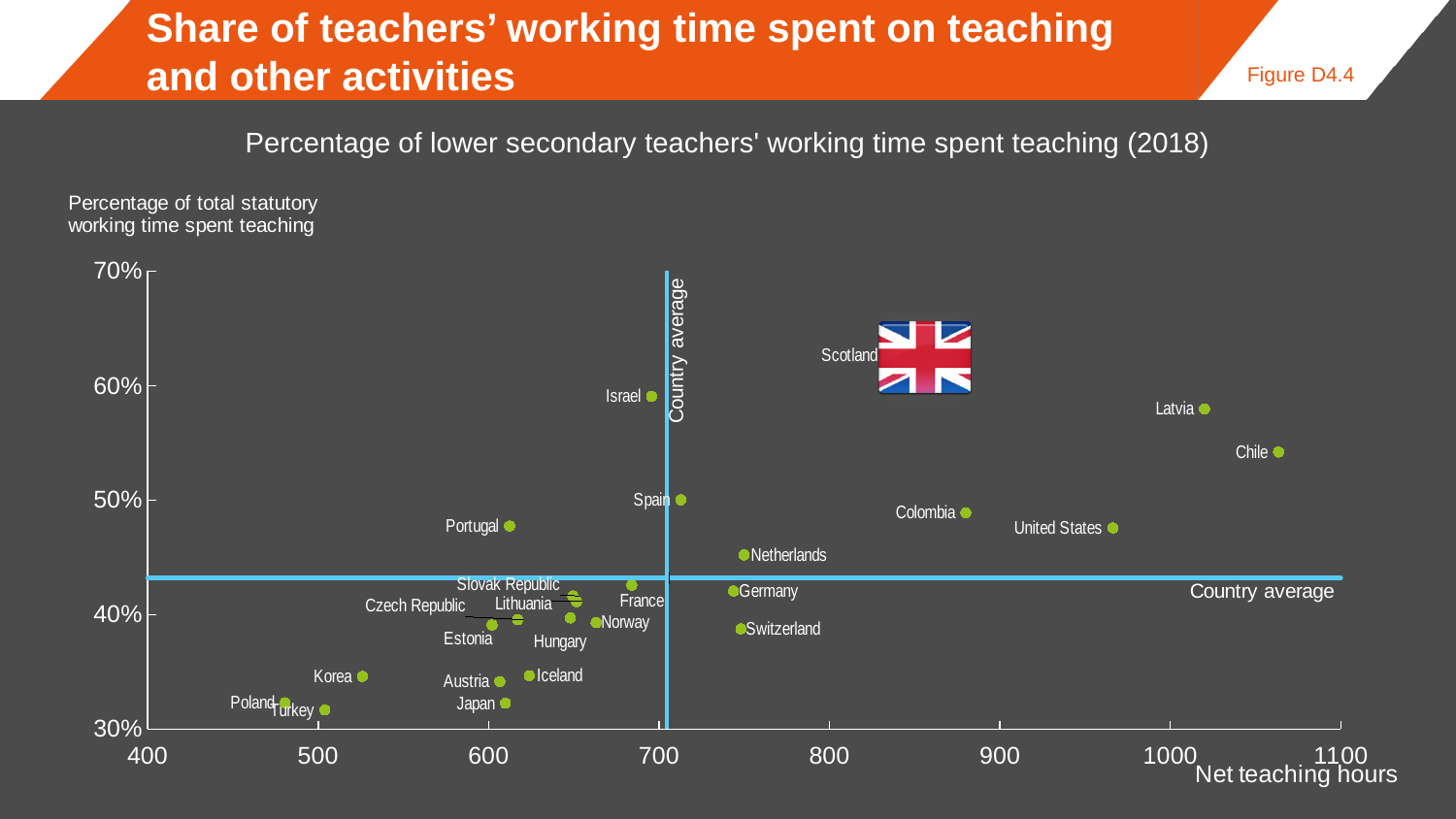
Are the net teaching hours for Chile greater or less than 1000? greater What kind of chart is shown on the slide? Scatter chart Which country has the highest percentage of total statutory working time spent teaching? Scotland Which has a higher percentage of working time spent teaching, Portugal or Korea? Portugal Is the percentage of working time spent teaching for Latvia greater or less than 50%? greater Which has a higher percentage of working time spent teaching, Scotland or Israel? Scotland Are the net teaching hours for the United States greater or less than 1000? less What is the label of the horizontal axis? Net teaching hours Which country has the highest net teaching hours? Chile